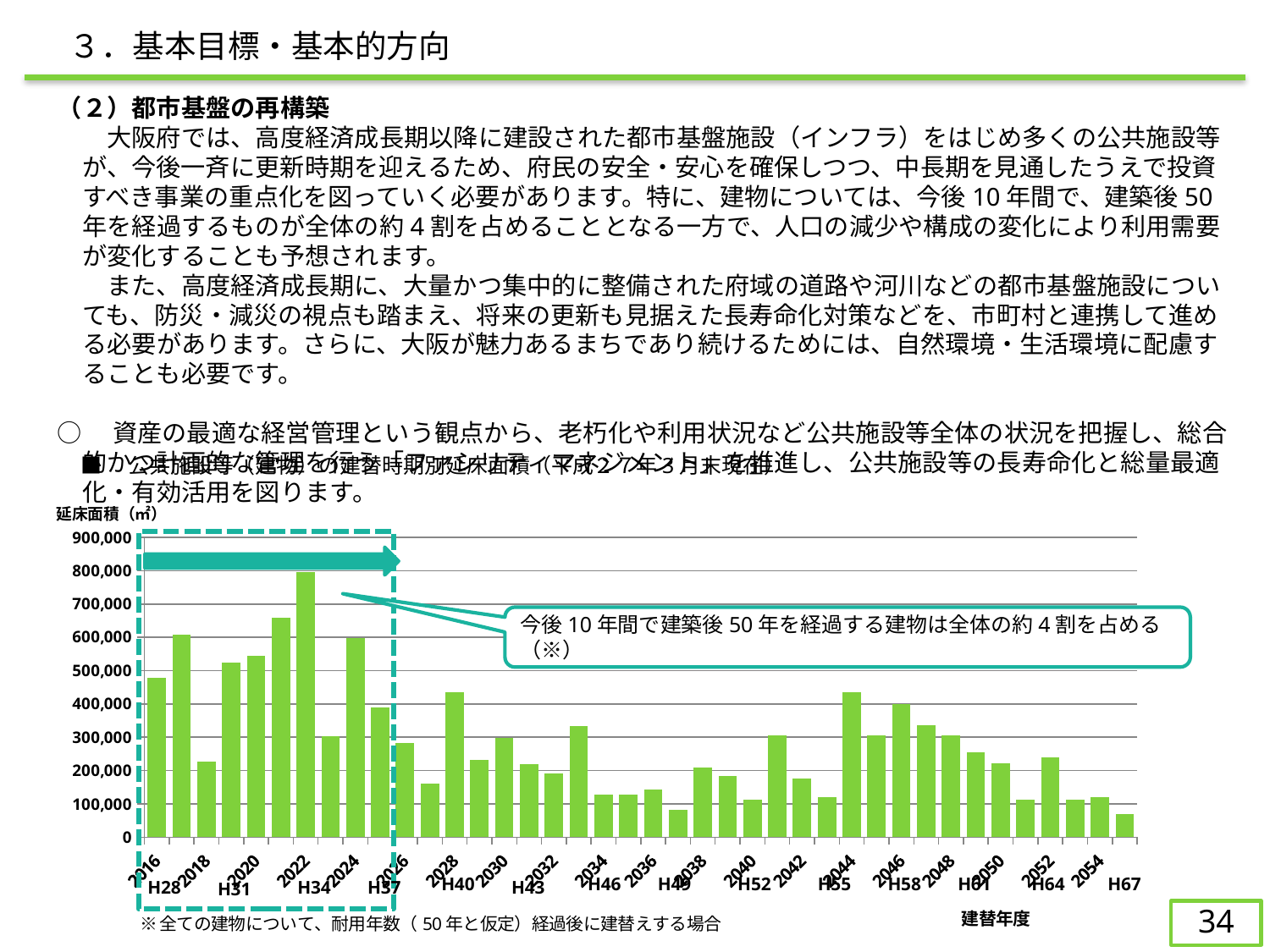
What kind of chart is shown on the slide? bar chart Is the value for 2022 greater or less than 700,000? greater Is the value for 2018 greater or less than 300,000? less What is the label on the horizontal axis of the chart? 建替年度 What is the label on the vertical axis of the chart? 延床面積（㎡） Which is larger, the value for 2022 or the value for 2024? 2022 Is the value for 2024 greater or less than 500,000? greater Which year has the highest bar in the chart? 2022 Which is larger, the value for 2016 or the value for 2018? 2016